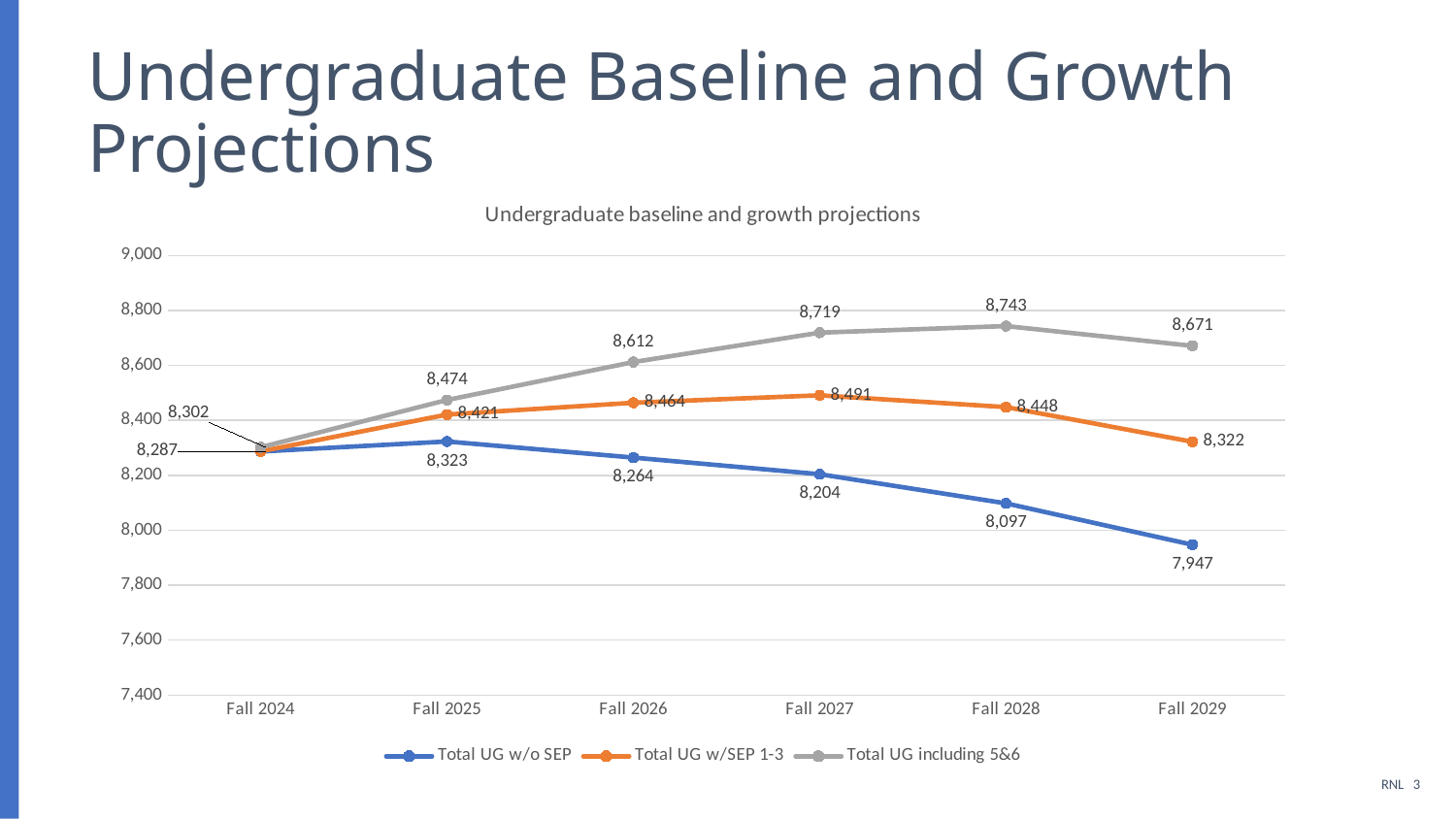
In which year is the Total UG w/o SEP series at its lowest? Fall 2029 What is the difference between Total UG including 5&6 and Total UG w/o SEP in Fall 2029? 724 How many series does the legend list? 3 What is the value of Total UG w/SEP 1-3 in Fall 2027? 8,491 How many years are shown on the x axis? 6 What is the value of Total UG including 5&6 in Fall 2028? 8,743 In Fall 2026, which is larger: Total UG w/SEP 1-3 or Total UG w/o SEP? Total UG w/SEP 1-3 What kind of chart is shown on the slide? line chart What is the value of Total UG w/o SEP in Fall 2029? 7,947 Is the value for Total UG w/o SEP in Fall 2028 greater or less than 8,200? less In which year does the Total UG including 5&6 series reach its highest value? Fall 2028 In which year does the Total UG w/SEP 1-3 series peak? Fall 2027